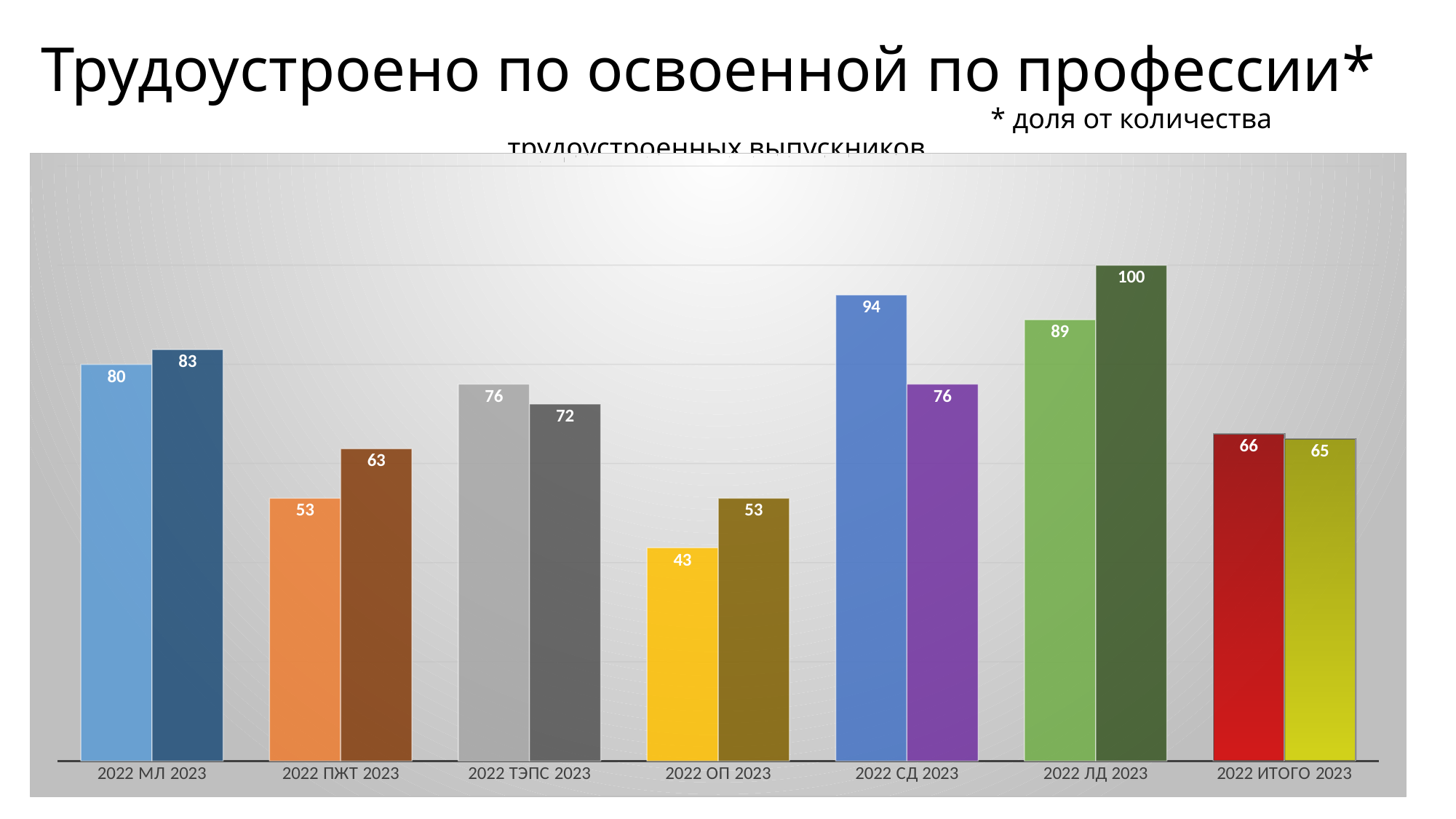
What is the difference between the 2022 and 2023 values for ПЖТ? 10 What is the value for СД in 2022? 94 What is the value for ИТОГО in 2023? 65 Which is larger for ТЭПС: the 2022 value or the 2023 value? 2022 How many categories (groups) are shown on the x axis? 7 Which category has the lowest value in 2022? ОП What is the title of the chart on the slide? Трудоустроено по освоенной по профессии* What kind of chart is shown on the slide? Bar chart What is the value for ЛД in 2023? 100 What is the value for ОП in 2022? 43 What is the difference between the 2022 and 2023 values for СД? 18 Which category has the highest value in 2023? ЛД